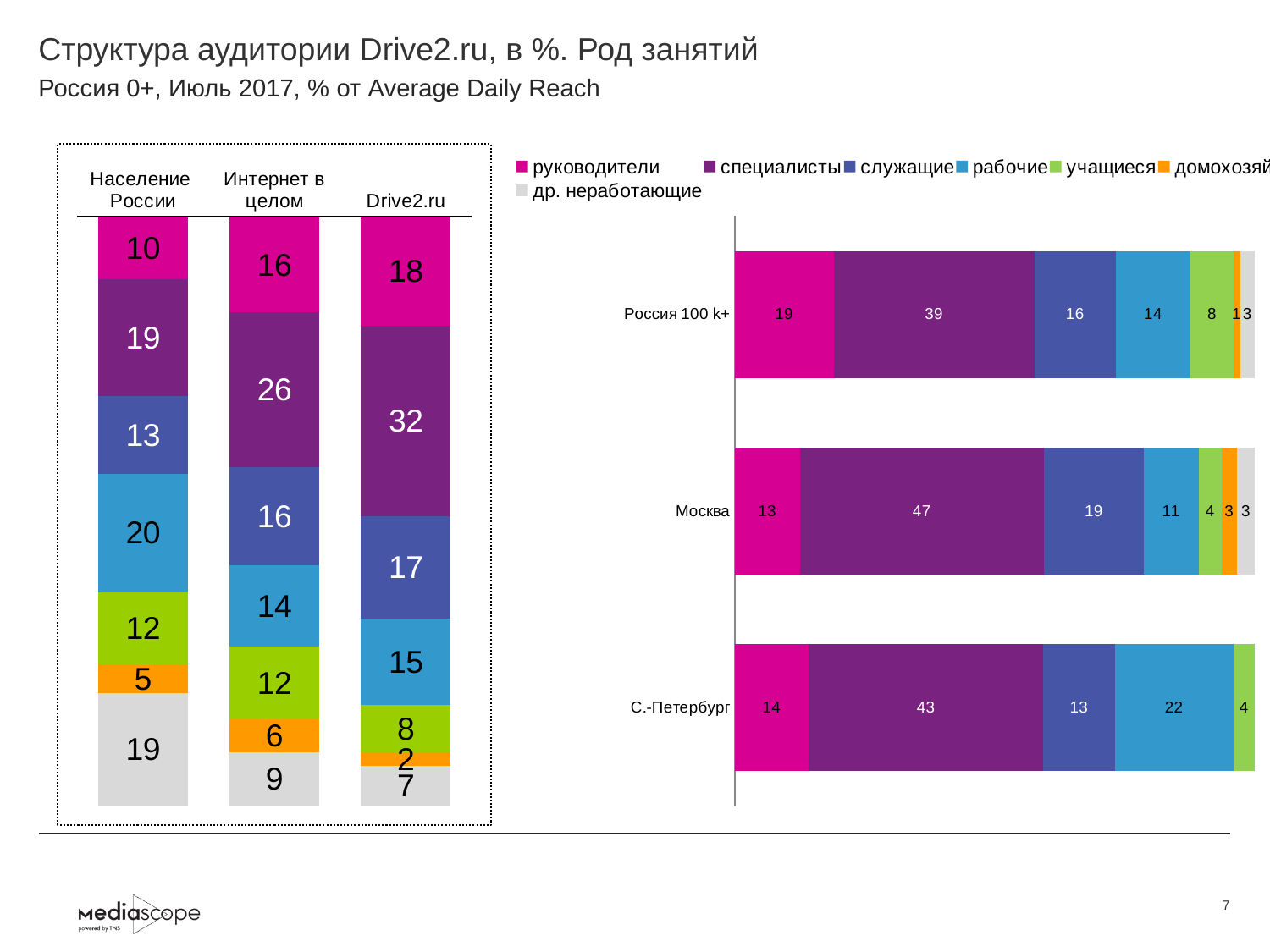
In the right chart, what is the value for специалисты for Москва? 47 What kind of chart is the right chart? Stacked bar chart How many series does the legend list? 7 In the left chart, what is the value for рабочие in the Население России column? 20 How many categories are shown on the right chart? 3 In the right chart, which category has the highest value for специалисты? Москва In the left chart, which column has the lowest value for руководители? Население России In the left chart, what is the value for специалисты in the Drive2.ru column? 32 In the right chart, which is larger: the руководители value for Россия 100 k+ or for Москва? Россия 100 k+ In the left chart, what is the total of the Drive2.ru stacked bar? 99 In the left chart, what is the difference between the специалисты values for Drive2.ru and Интернет в целом? 6 In the right chart, what is the value for рабочие for С.-Петербург? 22